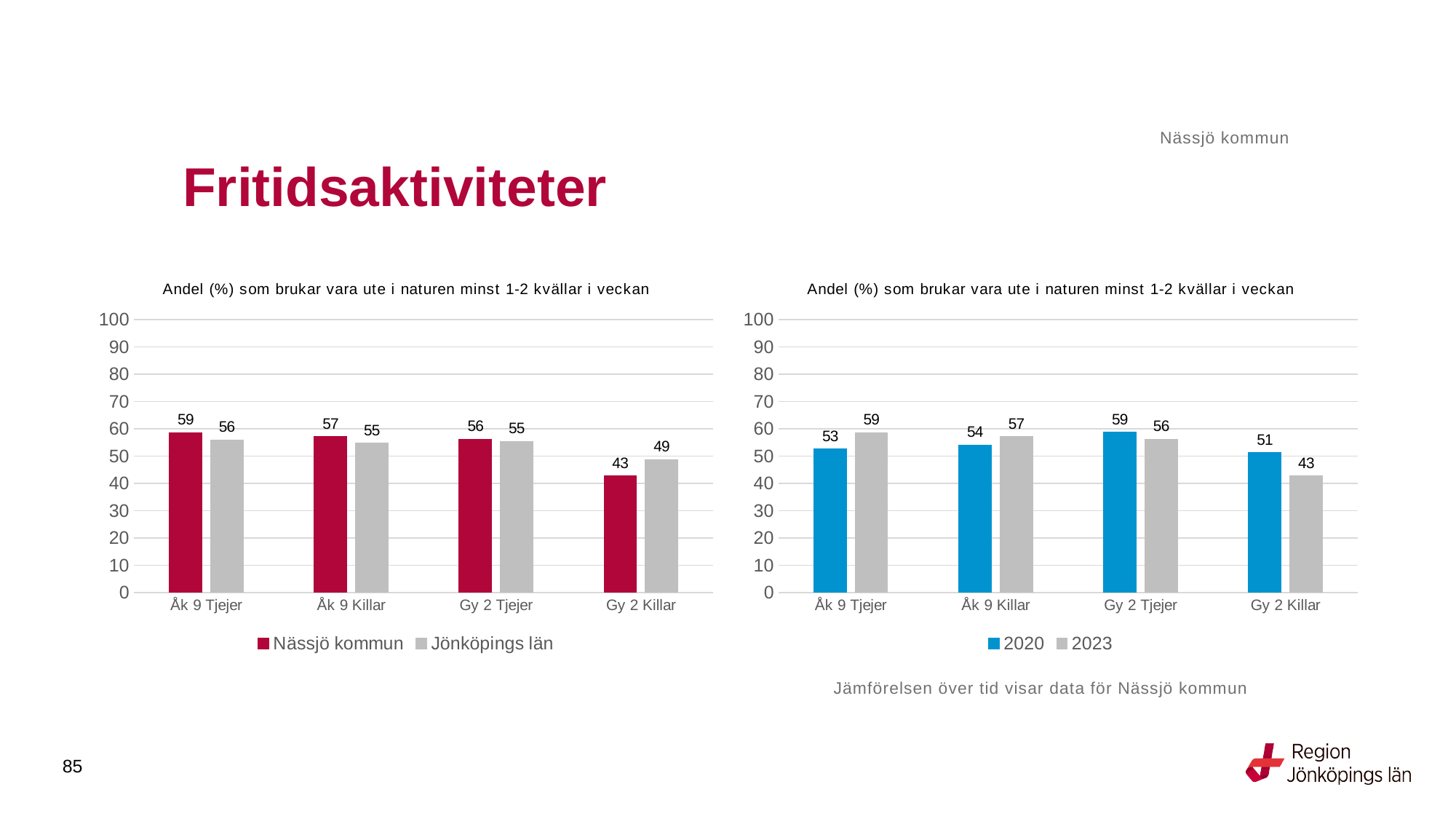
In the right chart, how many series does the legend list? 2 In the right chart, what is the value for 2023 for Gy 2 Killar? 43 In the left chart, what is the value for Jönköpings län for Gy 2 Killar? 49 How many categories are shown on the x axis of the left chart? 4 In the right chart, what is the difference between 2020 and 2023 for Gy 2 Killar? 8 In the left chart, what is the difference between Nässjö kommun and Jönköpings län for Gy 2 Killar? 6 In the left chart, which is larger for Åk 9 Killar: Nässjö kommun or Jönköpings län? Nässjö kommun In the right chart, which category has the highest value for 2023? Åk 9 Tjejer In the right chart, what is the value for 2020 for Gy 2 Tjejer? 59 In the left chart, which category has the lowest value for Nässjö kommun? Gy 2 Killar In the left chart, what is the value for Nässjö kommun for Åk 9 Tjejer? 59 What kind of chart is the right chart? Bar chart